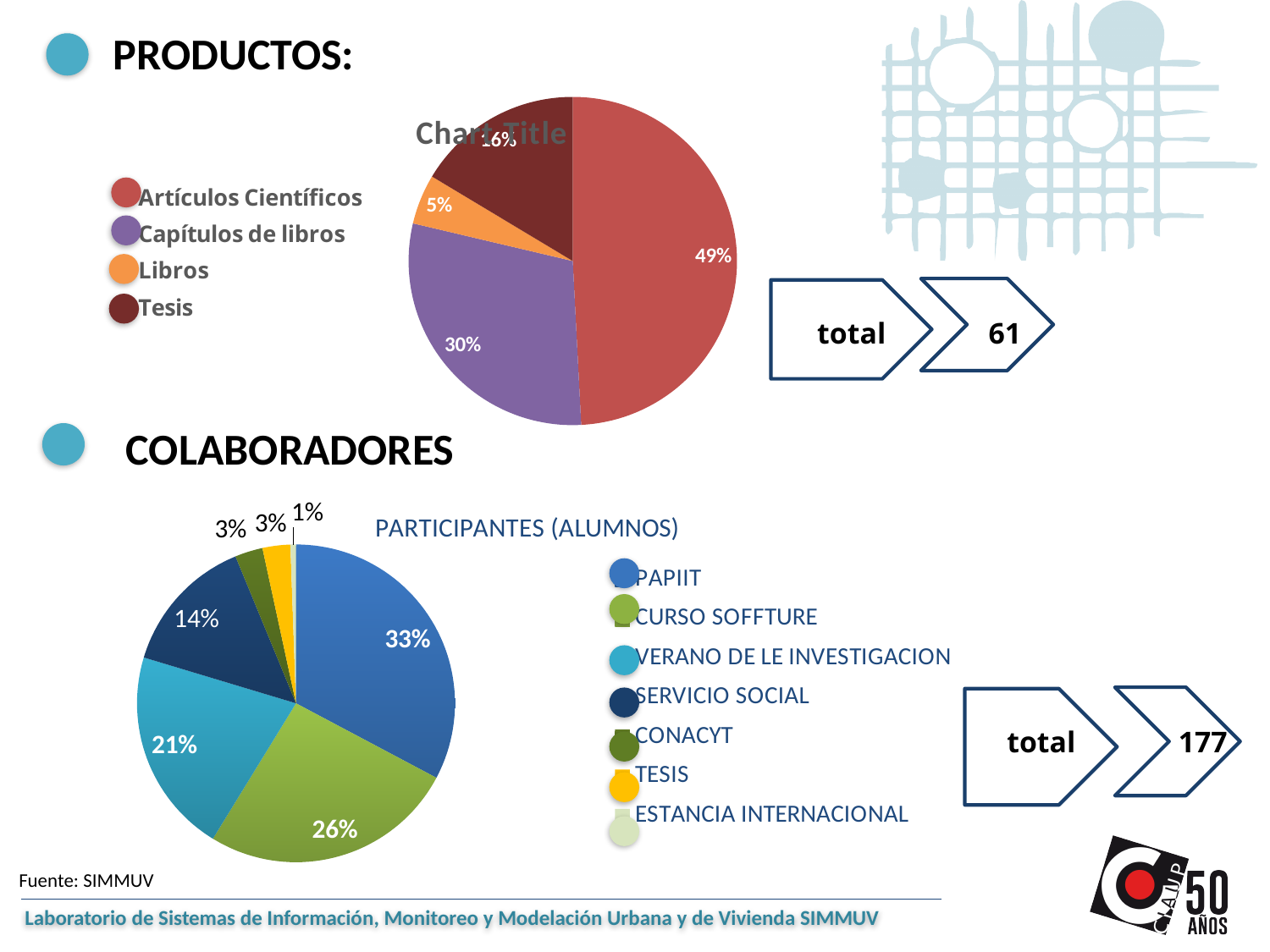
How many categories does the legend of the top pie chart under PRODUCTOS list? 4 What kind of chart is the PARTICIPANTES (ALUMNOS) chart? Pie chart In the PARTICIPANTES (ALUMNOS) pie chart, which category has the smallest slice? ESTANCIA INTERNACIONAL In the PARTICIPANTES (ALUMNOS) pie chart, what share is labelled for SERVICIO SOCIAL? 14% In the top pie chart under PRODUCTOS, how many percentage points larger is Tesis than Libros? 11 In the top pie chart under PRODUCTOS, which category has the largest slice? Artículos Científicos How many categories does the legend of the PARTICIPANTES (ALUMNOS) pie chart list? 7 In the top pie chart under PRODUCTOS, which category has the smallest slice? Libros In the top pie chart under PRODUCTOS, what share is labelled for Artículos Científicos? 49% In the top pie chart under PRODUCTOS, what share is labelled for Capítulos de libros? 30% In the PARTICIPANTES (ALUMNOS) pie chart, what share is labelled for PAPIIT? 33% In the PARTICIPANTES (ALUMNOS) pie chart, which is larger, CURSO SOFFTURE or VERANO DE LE INVESTIGACION? CURSO SOFFTURE